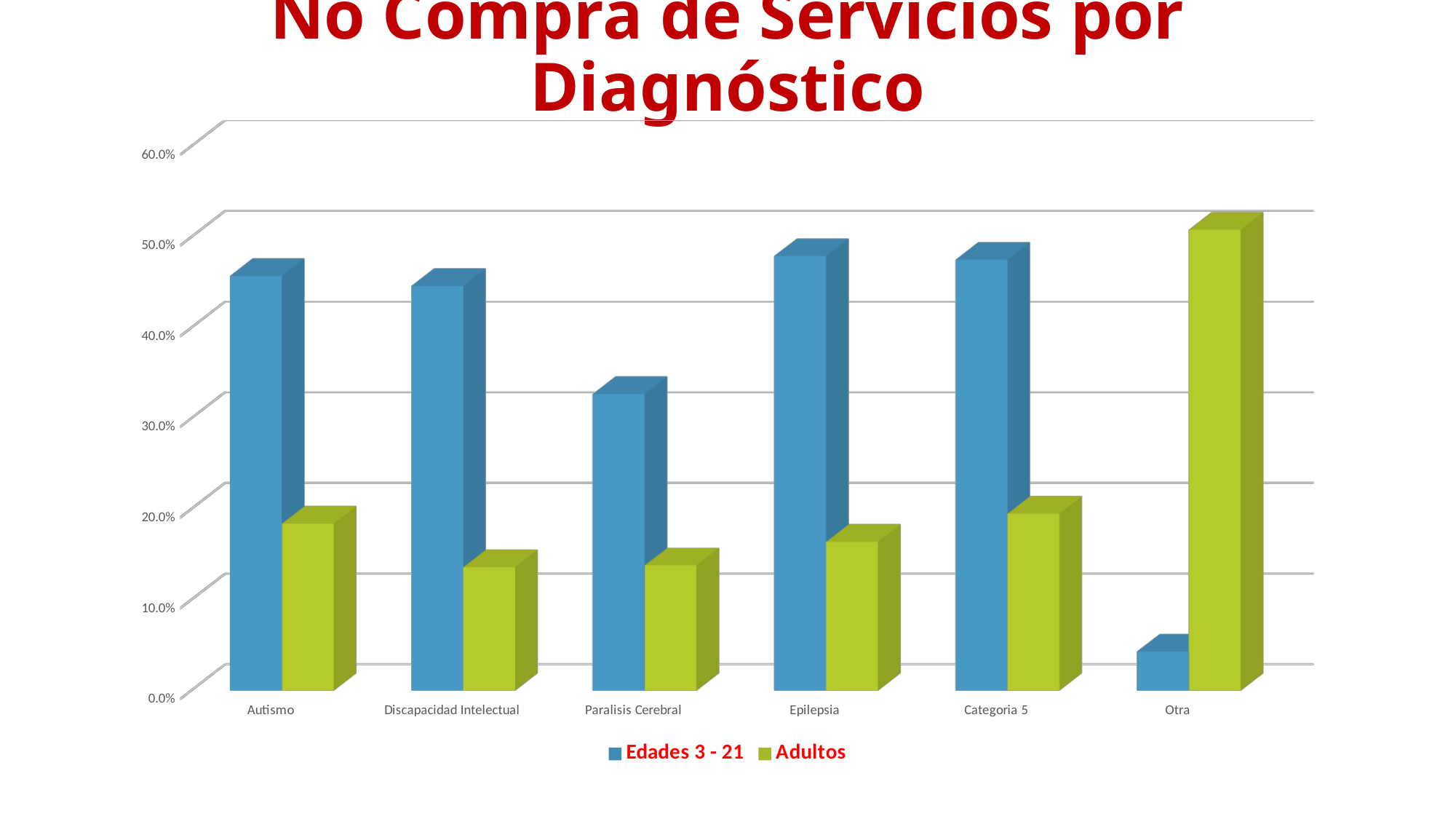
Is the Adultos value for Autismo greater or less than 30.0%? less What kind of chart is shown on the slide? bar chart How many diagnosis categories are shown on the x axis? 6 Which category has the lowest value for the Edades 3 - 21 series? Otra Is the Adultos value for Otra greater or less than 40.0%? greater For Autismo, which series has the larger value, Edades 3 - 21 or Adultos? Edades 3 - 21 For Otra, which series has the larger value, Edades 3 - 21 or Adultos? Adultos Which category has the highest value for the Adultos series? Otra Is the Edades 3 - 21 value for Paralisis Cerebral greater or less than 40.0%? less How many series does the legend list? 2 What colour are the bars for the Adultos series? green